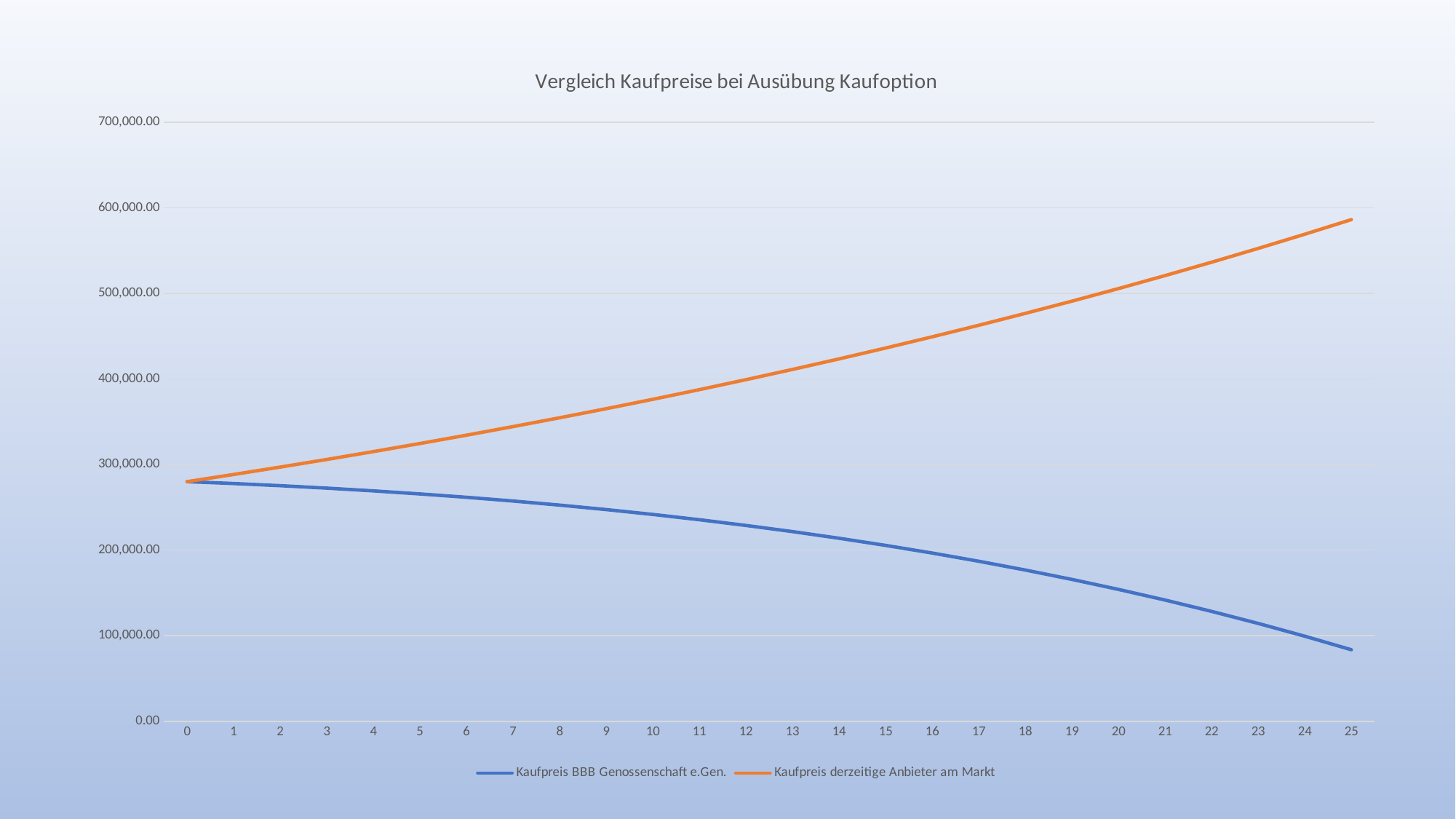
Does the value for Kaufpreis BBB Genossenschaft e.Gen. rise or fall from 0 to 25 along the x axis? fall How many series does the legend list? 2 Is the value for Kaufpreis derzeitige Anbieter am Markt at x = 25 greater or less than 500,000.00? greater Is the value for Kaufpreis BBB Genossenschaft e.Gen. at x = 25 greater or less than 100,000.00? less What kind of chart is shown on the slide? line chart Which series is drawn in orange? Kaufpreis derzeitige Anbieter am Markt Is the value for Kaufpreis derzeitige Anbieter am Markt at x = 5 greater or less than 300,000.00? greater What is the title of the chart? Vergleich Kaufpreise bei Ausübung Kaufoption How many points are plotted along the x axis for each series? 26 At x = 25, which series has the larger value, Kaufpreis BBB Genossenschaft e.Gen. or Kaufpreis derzeitige Anbieter am Markt? Kaufpreis derzeitige Anbieter am Markt Does the value for Kaufpreis derzeitige Anbieter am Markt rise or fall from 0 to 25 along the x axis? rise